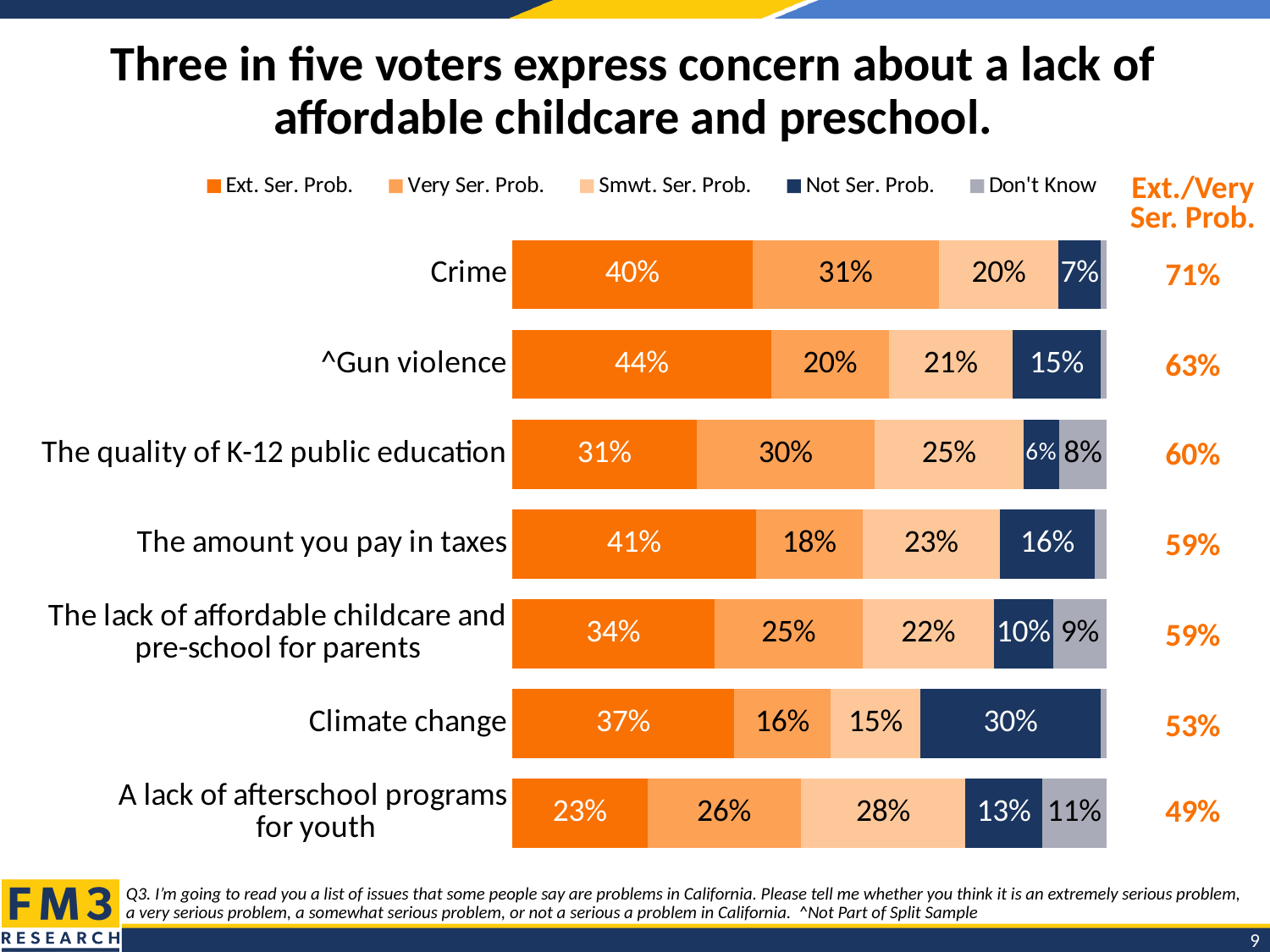
Which issue has the highest Ext. Ser. Prob. percentage? ^Gun violence Which has a larger Smwt. Ser. Prob. value: a lack of afterschool programs for youth or climate change? A lack of afterschool programs for youth How many percentage points higher is the Ext./Very Ser. Prob. value for crime than for gun violence? 8 percentage points What percentage of voters say crime is an extremely serious problem (Ext. Ser. Prob.)? 40% How many series does the legend list? 5 What is the Not Ser. Prob. value for climate change? 30% What kind of chart is shown on the slide? Stacked bar chart How many issues are listed in the chart? 7 What is the Don't Know value for a lack of afterschool programs for youth? 11% What is the combined Ext./Very Ser. Prob. value for the lack of affordable childcare and pre-school for parents? 59% Which issue has the lowest combined Ext./Very Ser. Prob. percentage? A lack of afterschool programs for youth What is the difference between the Ext. Ser. Prob. values for the amount you pay in taxes and the lack of affordable childcare and pre-school for parents? 7 percentage points